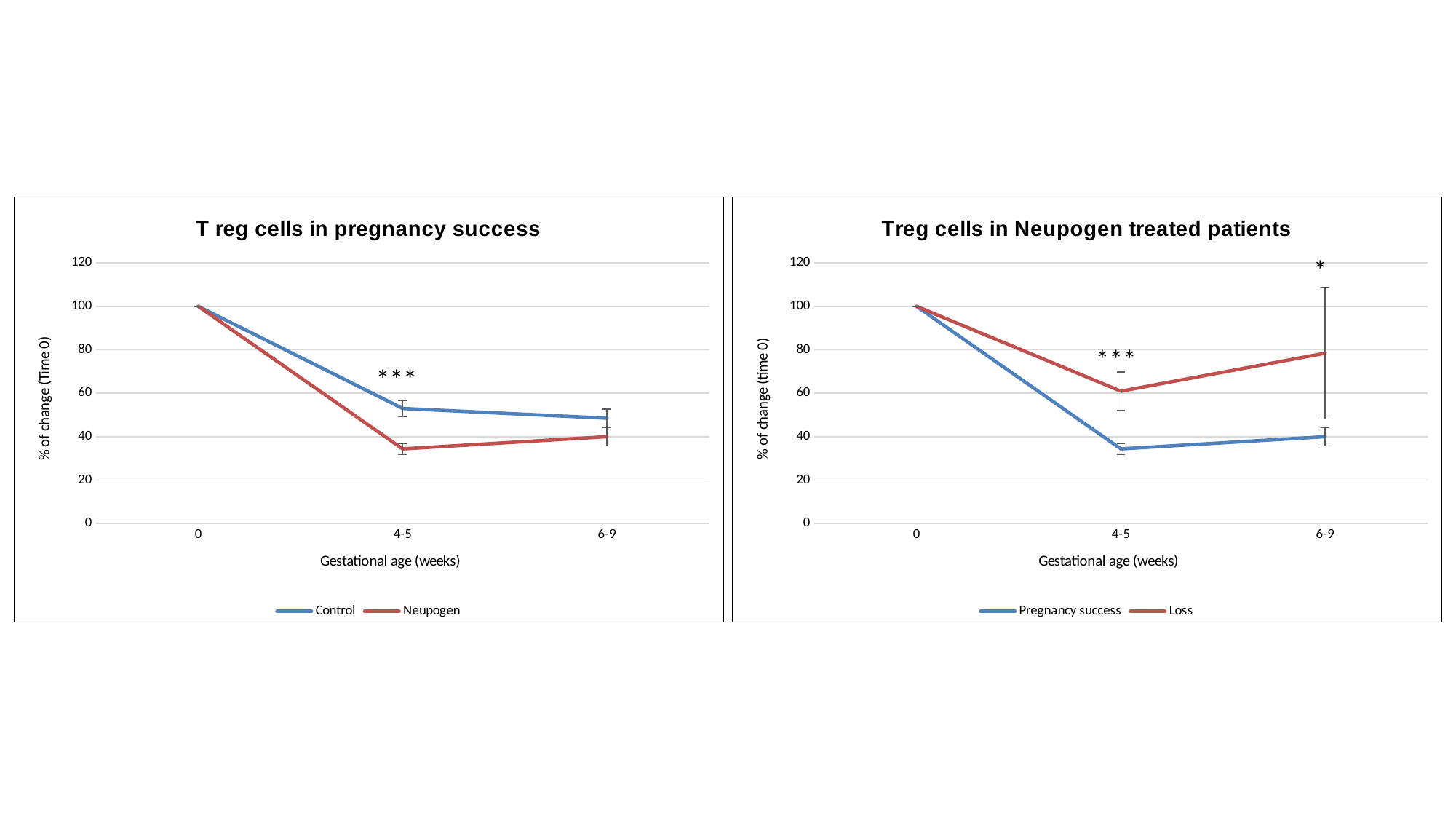
In the left chart 'T reg cells in pregnancy success', how many gestational age categories are shown on the x axis? 3 In the right chart 'Treg cells in Neupogen treated patients', is the value for Loss at 6-9 weeks greater or less than 60? greater What is the x-axis title of the right chart 'Treg cells in Neupogen treated patients'? Gestational age (weeks) In the left chart 'T reg cells in pregnancy success', which series has the higher value at 4-5 weeks, Control or Neupogen? Control In the right chart 'Treg cells in Neupogen treated patients', does the Loss series rise or fall from 4-5 weeks to 6-9 weeks? Rise In the left chart 'T reg cells in pregnancy success', is the value for Neupogen at 4-5 weeks greater or less than 40? less In the right chart 'Treg cells in Neupogen treated patients', which series has the higher value at 6-9 weeks, Pregnancy success or Loss? Loss In the left chart 'T reg cells in pregnancy success', how many series does the legend list? 2 In the left chart 'T reg cells in pregnancy success', what is the value for Control at gestational age 0? 100 In the right chart 'Treg cells in Neupogen treated patients', what are the two series named in the legend? Pregnancy success and Loss What kind of chart is the left chart titled 'T reg cells in pregnancy success'? Line chart In the left chart 'T reg cells in pregnancy success', is the value for Control at 4-5 weeks greater or less than 40? greater